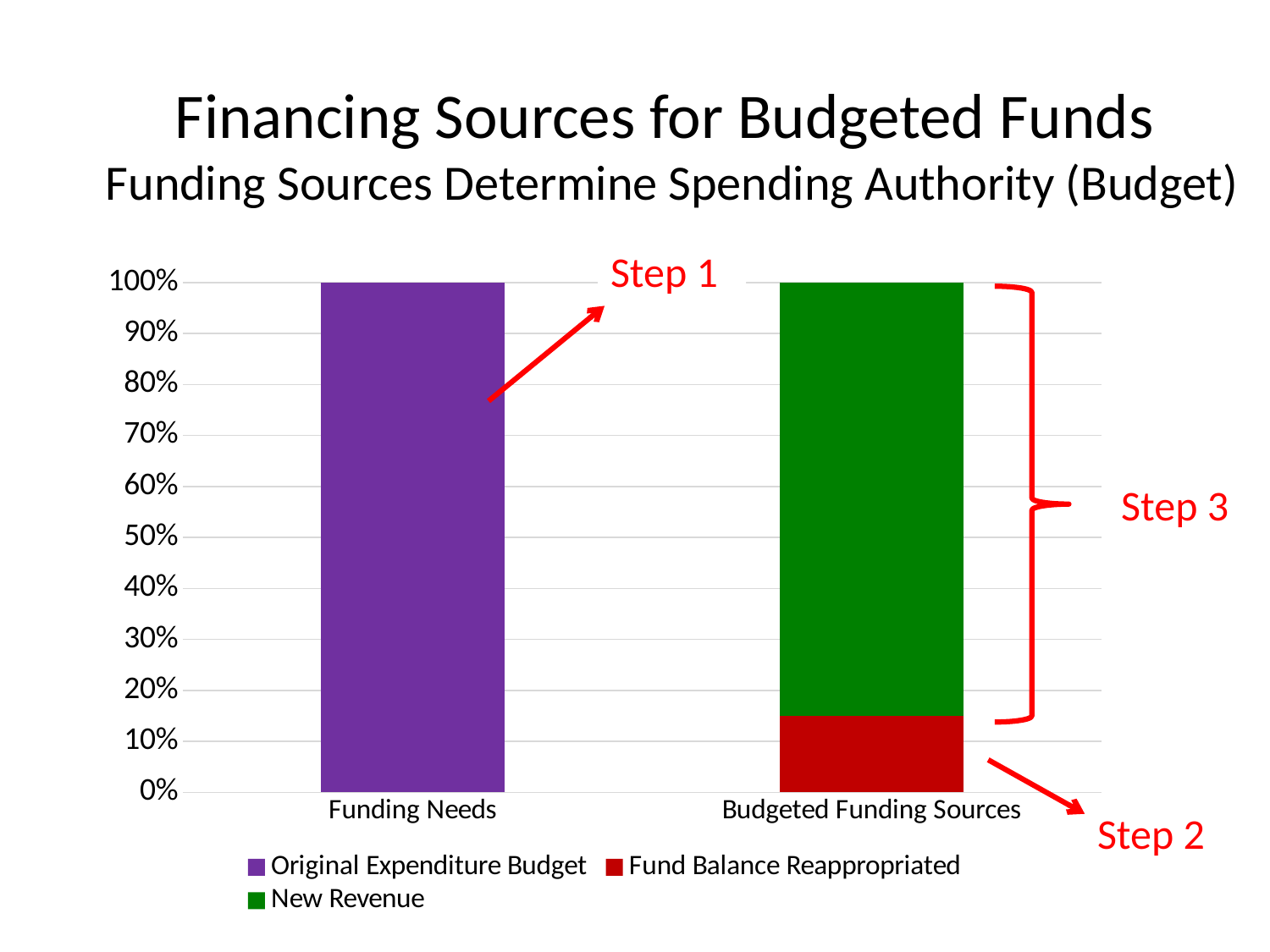
Is the value for Fund Balance Reappropriated in Budgeted Funding Sources greater or less than 10%? greater Is the value for Fund Balance Reappropriated in Budgeted Funding Sources greater or less than 20%? less How many categories are shown on the x axis of the chart? 2 What colour represents New Revenue in the chart? green How many series does the chart's legend list? 3 What is the value of Original Expenditure Budget for Funding Needs? 100% Which series is shown in purple in the chart? Original Expenditure Budget Is the value for New Revenue in Budgeted Funding Sources greater or less than 50%? greater In the Budgeted Funding Sources bar, which is larger: New Revenue or Fund Balance Reappropriated? New Revenue What is the total of the stacked bar for Budgeted Funding Sources? 100% What kind of chart is shown on the slide? bar chart